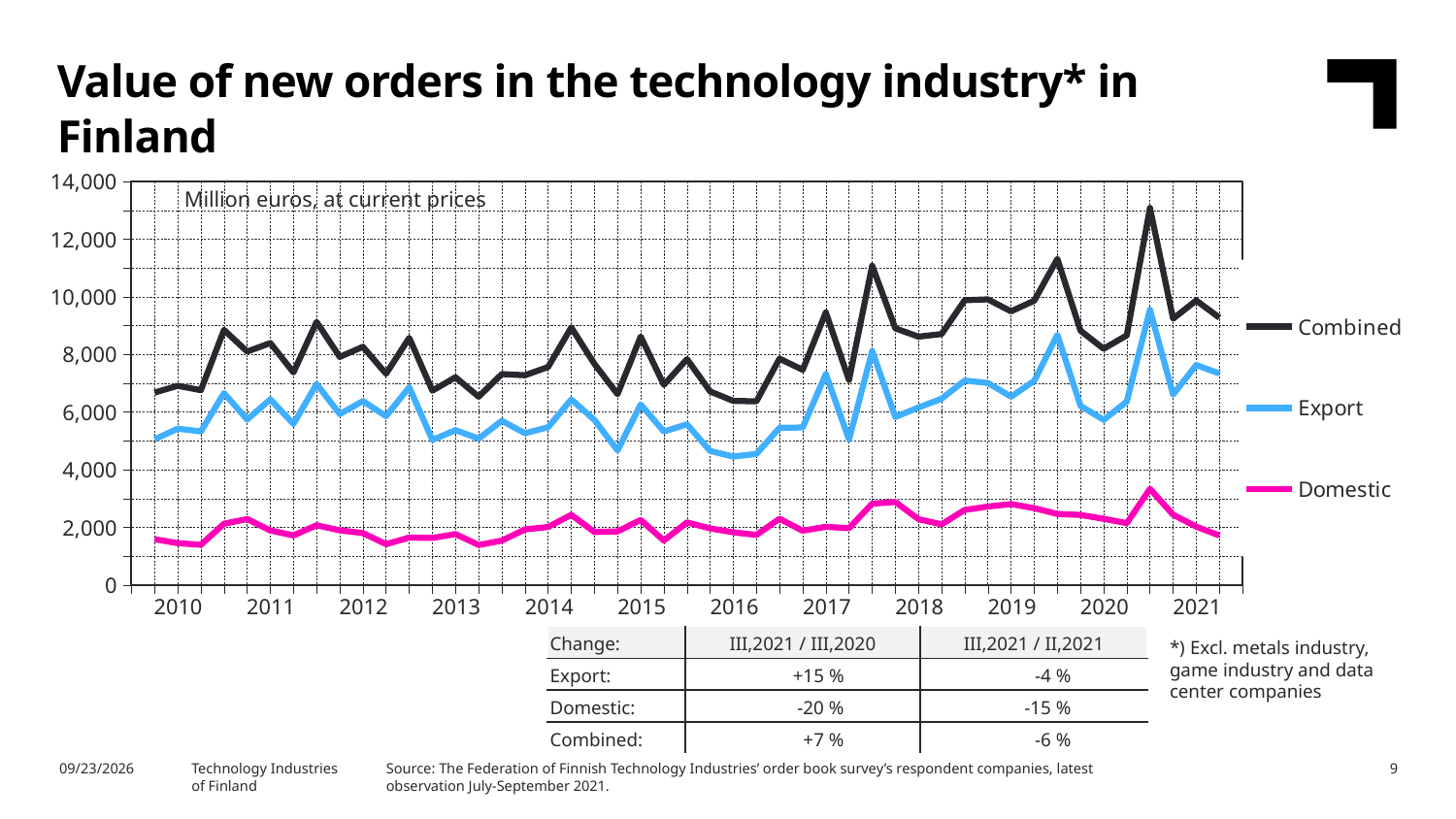
Is the highest peak of the Export series (around 2020) greater or less than 8,000? greater What kind of chart is shown on the slide? line chart How many series does the chart's legend list? 3 What unit label is printed inside the chart area? Million euros, at current prices What are the three series named in the chart's legend? Combined, Export, Domestic Which series has the lowest values on the chart? Domestic Which series has higher values throughout the chart, Export or Domestic? Export Is the highest value of the Domestic series greater or less than 4,000? less Is the highest peak of the Combined series (around 2020) greater or less than 12,000? greater Which series reaches the highest value on the chart? Combined According to the table below the chart, what is the Export change for III,2021 / III,2020? +15 % How many years are labelled on the x axis of the chart? 12